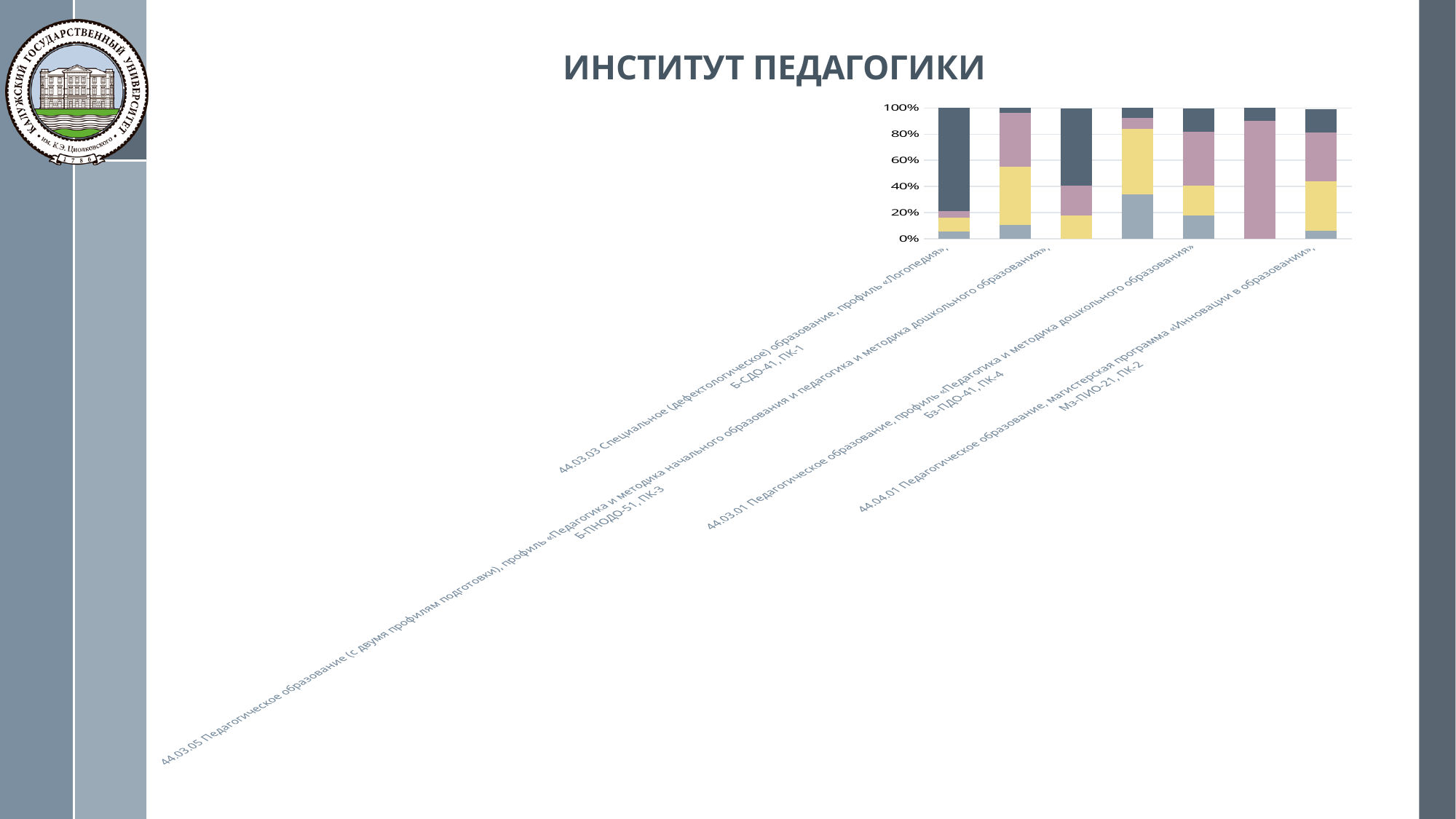
Is the share of the light grey-blue segment in the fourth bar from the left greater or less than 20%? greater Is the share of the yellow segment in the third bar from the left greater or less than 40%? less What is the title shown at the top of the slide? ИНСТИТУТ ПЕДАГОГИКИ Is the share of the dark grey segment in the leftmost bar greater or less than 60%? greater What kind of chart is shown on the slide? stacked bar chart How many bars does the chart contain? 7 What is the highest value shown on the chart's vertical axis? 100% Which bar has the larger pink segment, the third bar from the left or the sixth bar from the left? the sixth bar In the second bar from the left, which segment is larger, the yellow one or the light grey-blue one? the yellow one Which bar has the largest dark grey segment? the leftmost bar